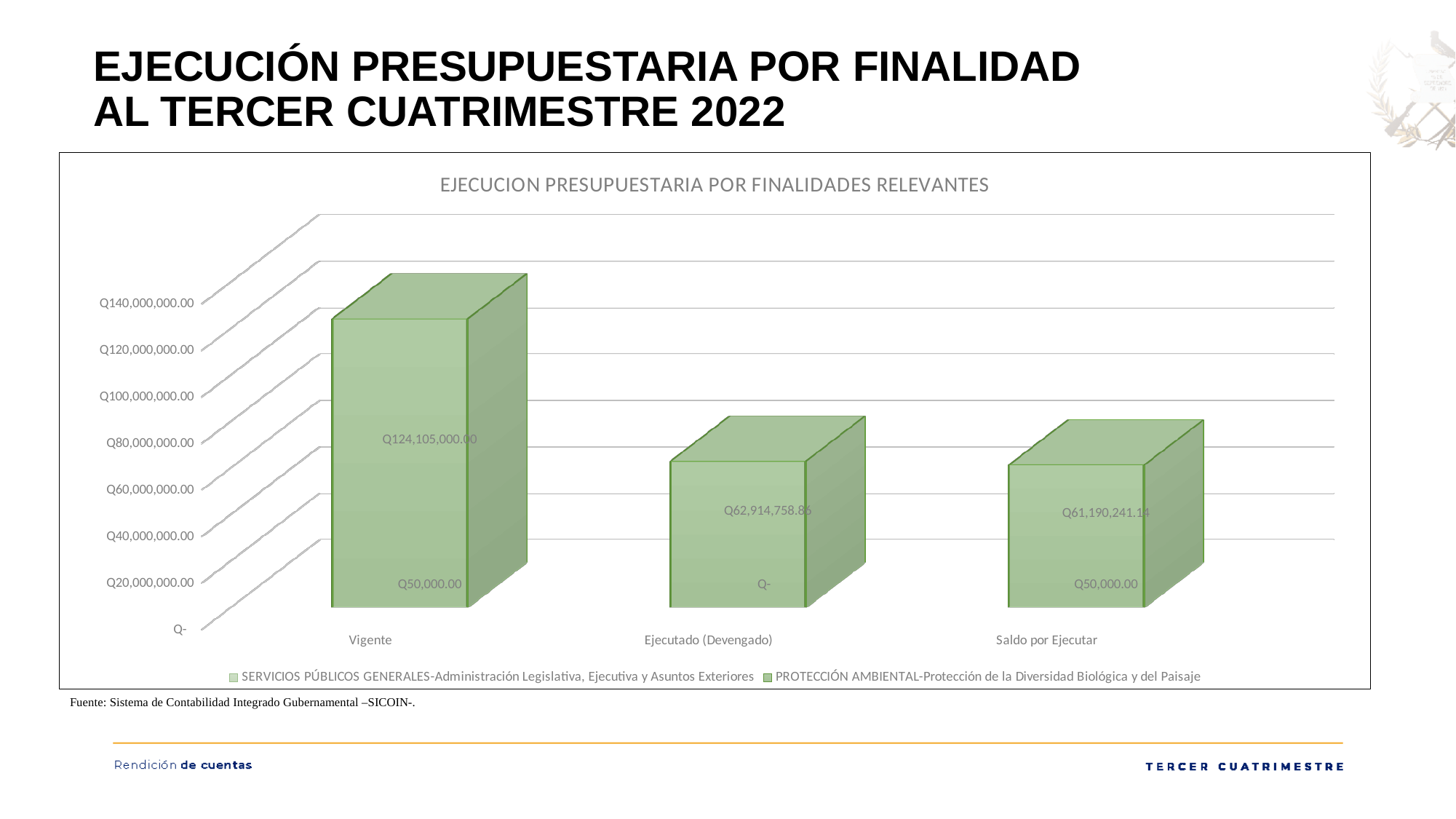
How many series does the legend list? 2 What is the value for SERVICIOS PÚBLICOS GENERALES in the Vigente category? Q50,000.00 What is the value for PROTECCIÓN AMBIENTAL in the Vigente category? Q124,105,000.00 What type of chart is shown on the slide? bar chart How many categories are shown on the x axis of the chart? 3 What is the value for PROTECCIÓN AMBIENTAL in the Ejecutado (Devengado) category? Q62,914,758.86 What is the difference between the SERVICIOS PÚBLICOS GENERALES values for Ejecutado (Devengado) and Saldo por Ejecutar? Q50,000.00 What is the title of the chart? EJECUCION PRESUPUESTARIA POR FINALIDADES RELEVANTES What is the value for SERVICIOS PÚBLICOS GENERALES in the Ejecutado (Devengado) category? Q- What is the value for SERVICIOS PÚBLICOS GENERALES in the Saldo por Ejecutar category? Q50,000.00 What is the total of the stacked bar for Vigente? Q124,155,000.00